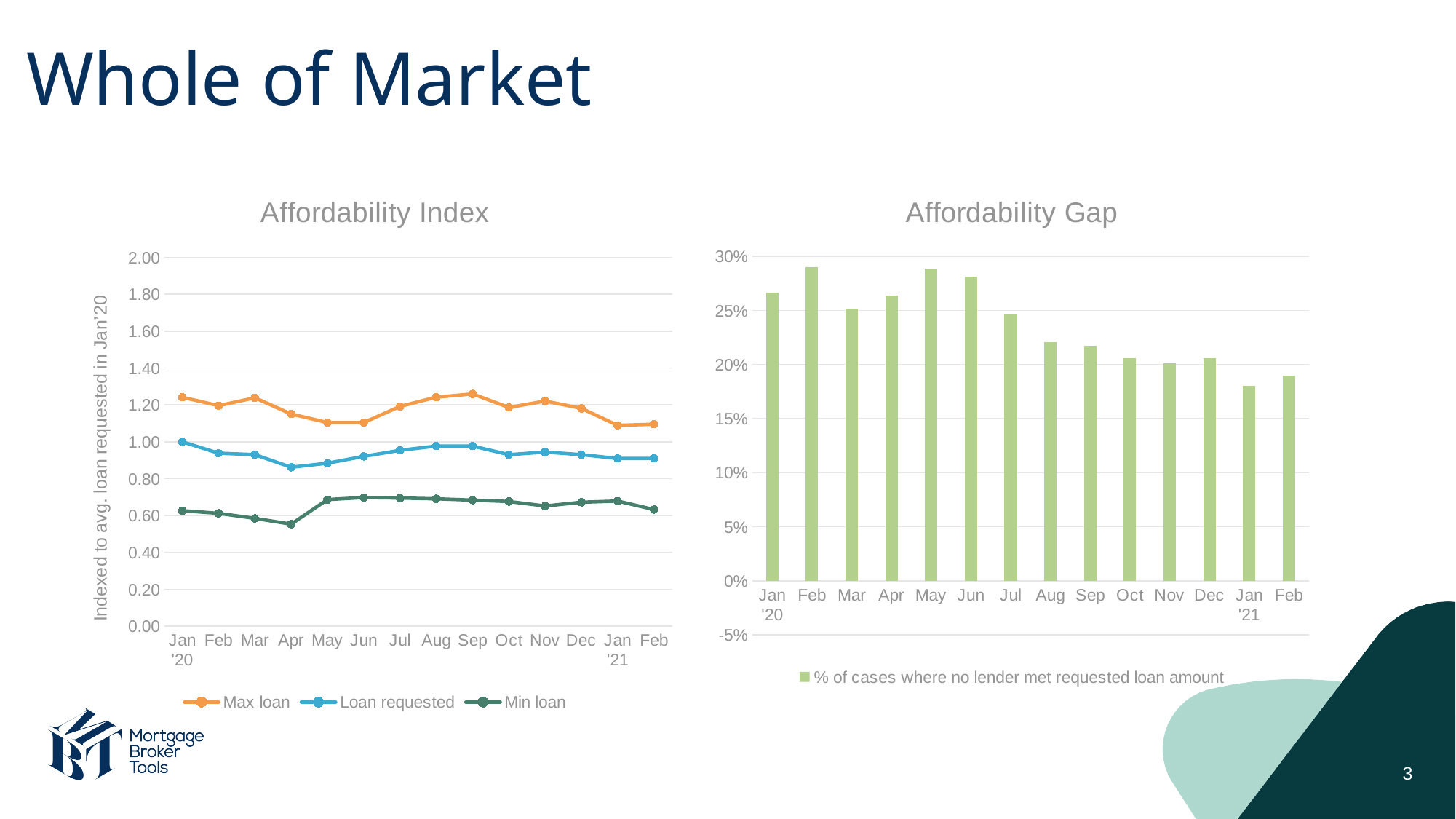
On the Affordability Gap chart, how many months are plotted? 14 What kind of chart is the Affordability Index chart? line chart On the Affordability Index chart, in which month is the Min loan line at its lowest? Apr '20 On the Affordability Index chart, how many series does the legend list? 3 On the Affordability Index chart, what is the value of Loan requested in Jan '20? 1.00 On the Affordability Index chart, is the Max loan value for Jan '20 larger or smaller than the Max loan value for Apr '20? larger What kind of chart is the Affordability Gap chart? bar chart On the Affordability Index chart, in which month is the Loan requested line at its lowest? Apr '20 On the Affordability Gap chart, do the values generally rise or fall from Jan '20 to Feb '21? fall On the Affordability Gap chart, is the value for Jan '20 greater or less than 25%? greater On the Affordability Index chart, is the Max loan value for Jan '20 greater or less than 1.20? greater On the Affordability Gap chart, is the value for Jan '21 greater or less than 20%? less